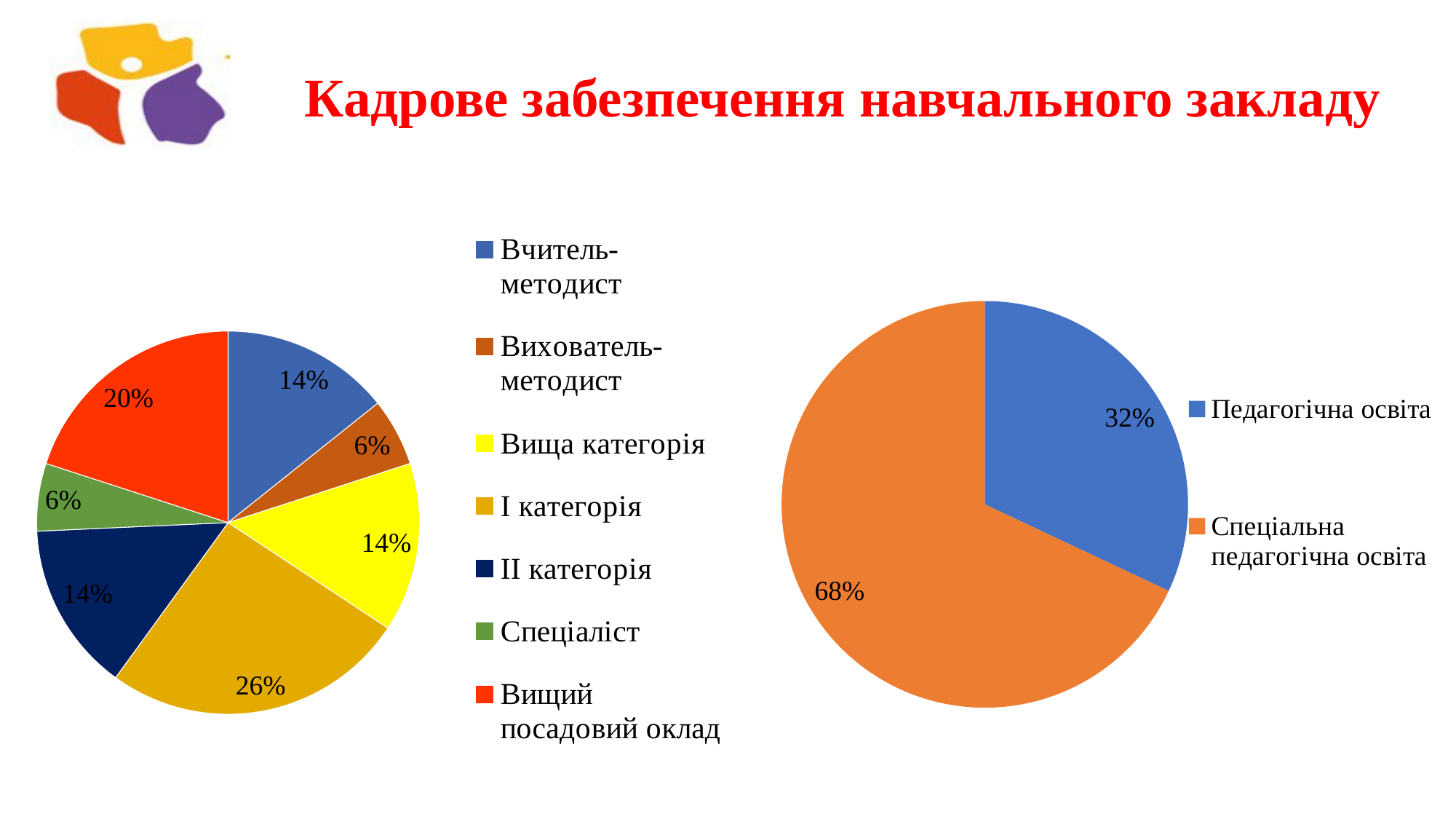
On the left pie chart, what share does "Вихователь-методист" have? 6% On the right pie chart, what share does "Педагогічна освіта" have? 32% On the left pie chart, which category has the largest share? I категорія On the right pie chart, what is the difference between the shares of "Спеціальна педагогічна освіта" and "Педагогічна освіта"? 36% On the right pie chart, what share does "Спеціальна педагогічна освіта" have? 68% On the left pie chart, what share does "Вищий посадовий оклад" have? 20% What type of chart is the right chart on the slide? Pie chart On the left pie chart, what share does "I категорія" have? 26% On the left pie chart, what is the difference between the shares of "I категорія" and "Вищий посадовий оклад"? 6% On the left pie chart, which is larger: the share of "Вчитель-методист" or the share of "Спеціаліст"? Вчитель-методист On the left pie chart, how many categories does the legend list? 7 On the right pie chart, which category has the largest share? Спеціальна педагогічна освіта